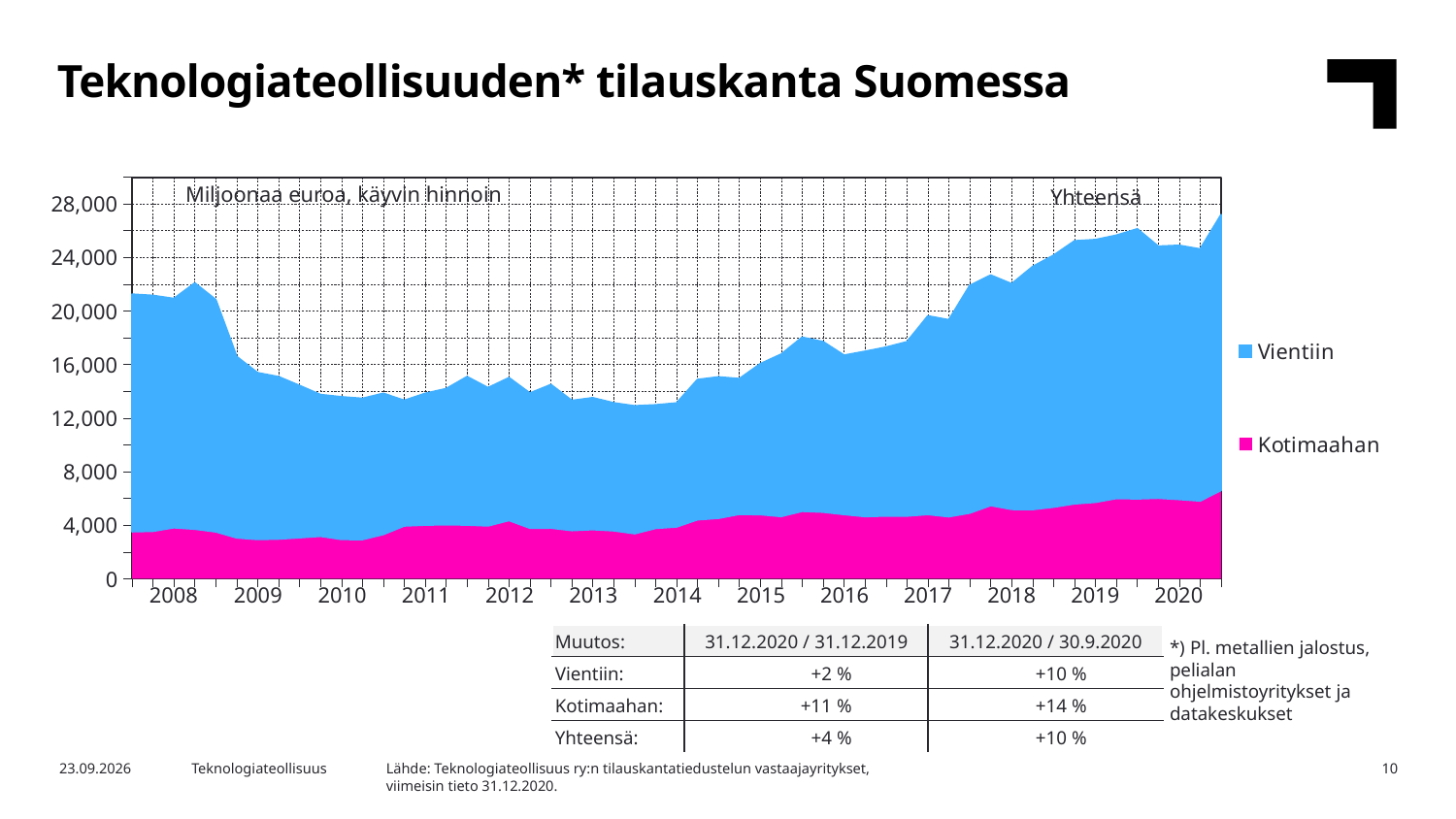
Is the total (Yhteensä) value at the end of 2020 greater or less than 24,000? greater Is the total (Yhteensä) value in 2013 greater or less than 16,000? less How many series does the chart legend list? 2 Does the total (Yhteensä) value rise or fall from 2013 to 2019? rise What unit label is shown at the top left of the chart? Miljoonaa euroa, käyvin hinnoin Is the Kotimaahan value in 2009 greater or less than 4,000? less Does the total (Yhteensä) value rise or fall from 2008 to 2009? fall What are the two series named in the chart legend? Vientiin and Kotimaahan How many years are labelled on the x axis of the chart? 13 What kind of chart is shown on the slide? Area chart Which series is larger throughout the chart, Vientiin or Kotimaahan? Vientiin